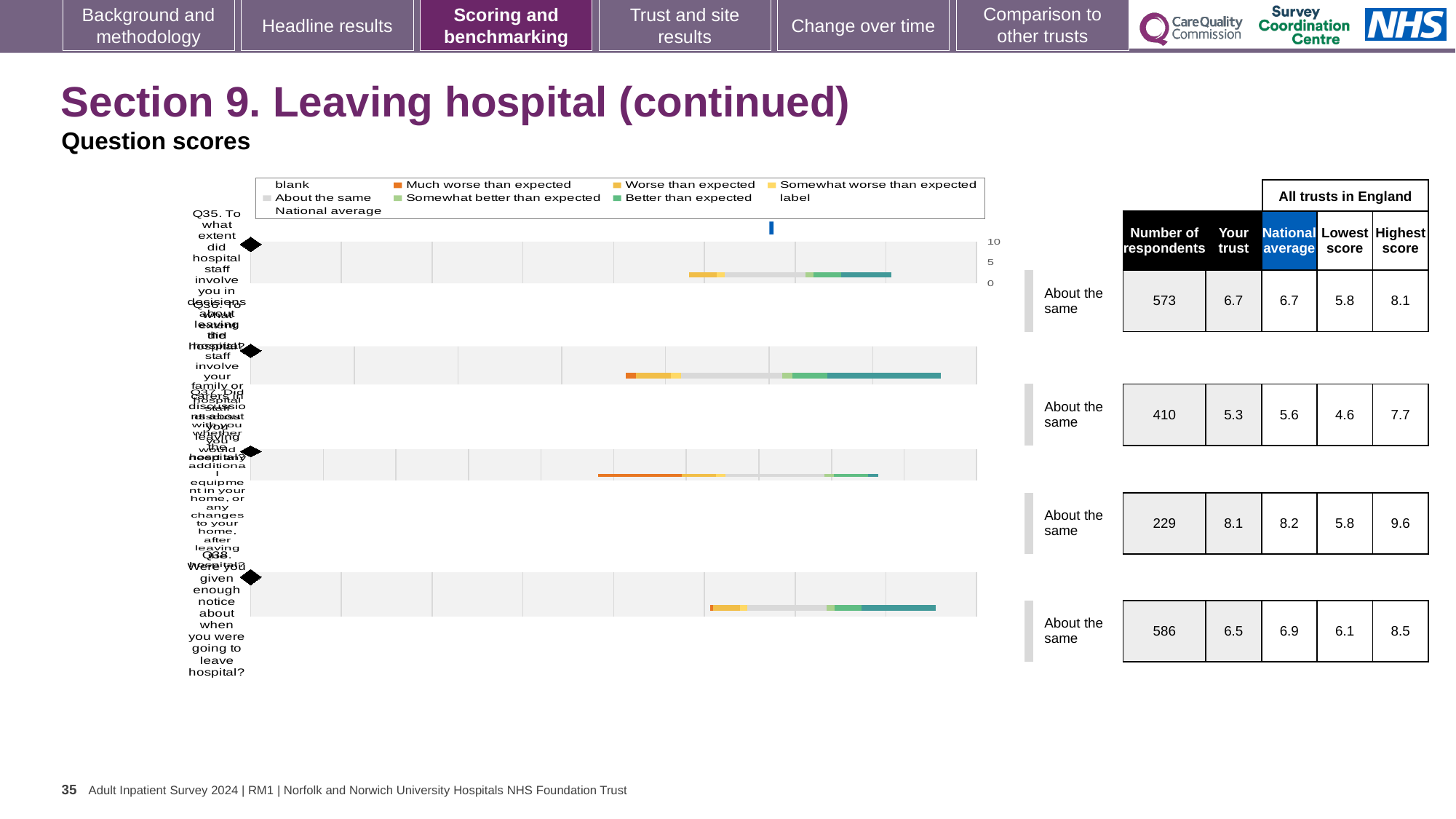
In the table, how many respondents are shown for Q35 (involving you in decisions about leaving hospital)? 573 What benchmark category is shown next to the chart for Q35 (involving you in decisions about leaving hospital)? About the same For Q38 (given enough notice about leaving hospital), which is larger: the 'Your trust' score or the national average? National average In the table, what is the 'Your trust' score for Q35 (involving you in decisions about leaving hospital)? 6.7 For Q38 (given enough notice about leaving hospital), what is the difference between the highest score and the lowest score in the table? 2.4 In the table, what is the national average for Q38 (given enough notice about when you were going to leave hospital)? 6.9 What kind of chart is used to show the question scores on this slide? Bar chart In the table, how many respondents are shown for Q38 (given enough notice about when you were going to leave hospital)? 586 What is the heading above the 'National average', 'Lowest score' and 'Highest score' columns in the table? All trusts in England How many questions (rows) are plotted in the question scores chart? 4 What is the highest 'Your trust' score shown in the table? 8.1 What is the smallest value in the 'Lowest score' column of the table? 4.6